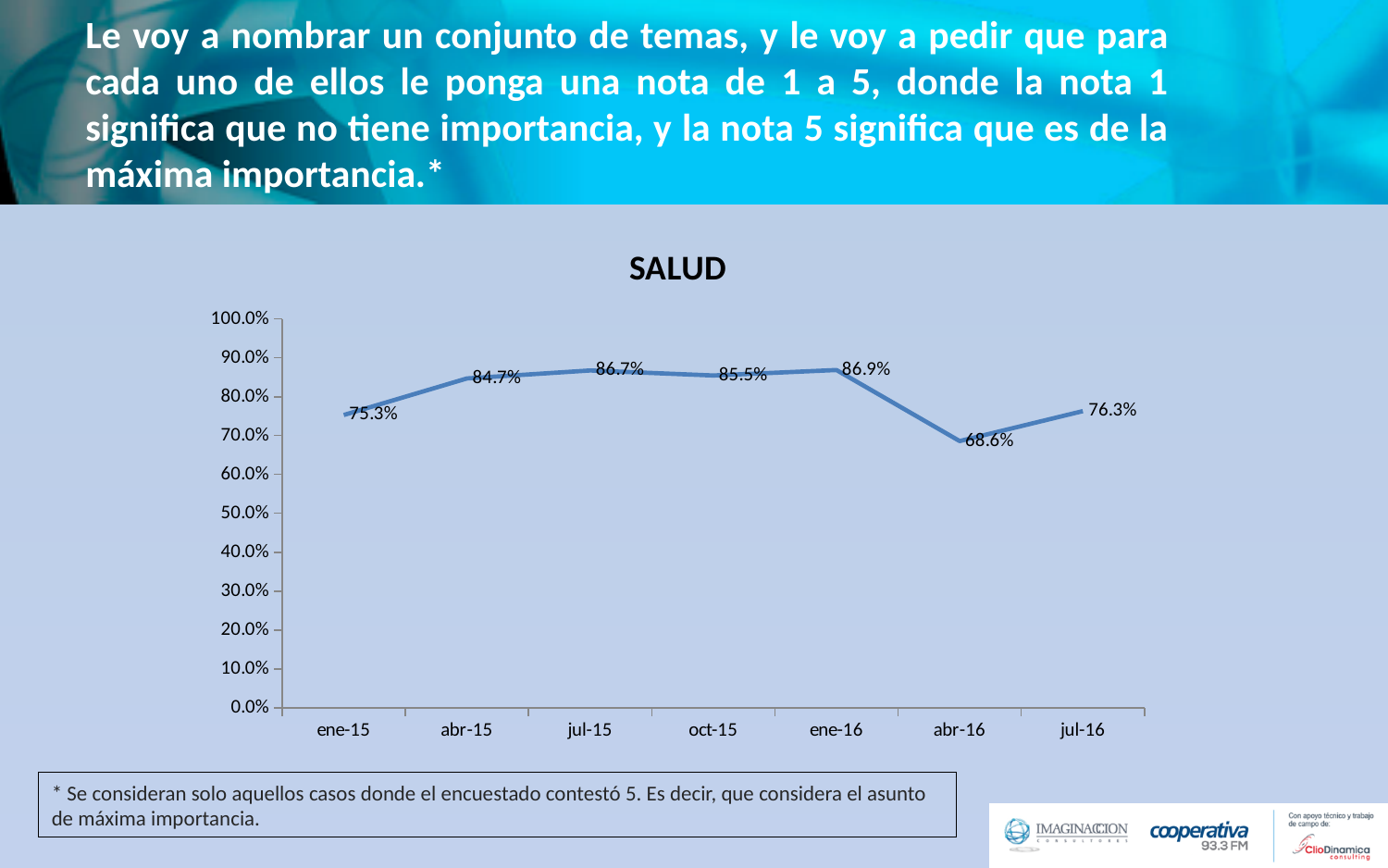
What is the difference between the values for ene-16 and abr-16? 18.3% Does the value rise or fall from ene-16 to abr-16? fall Which period has the highest value? ene-16 What type of chart is shown on the slide? line chart What is the value for ene-15? 75.3% What is the value for jul-16? 76.3% What is the value for oct-15? 85.5% What is the title of the chart? SALUD How many data points are plotted on the line? 7 What is the value for abr-16? 68.6% Which is larger, the value for abr-15 or the value for jul-16? abr-15 Which period has the lowest value? abr-16